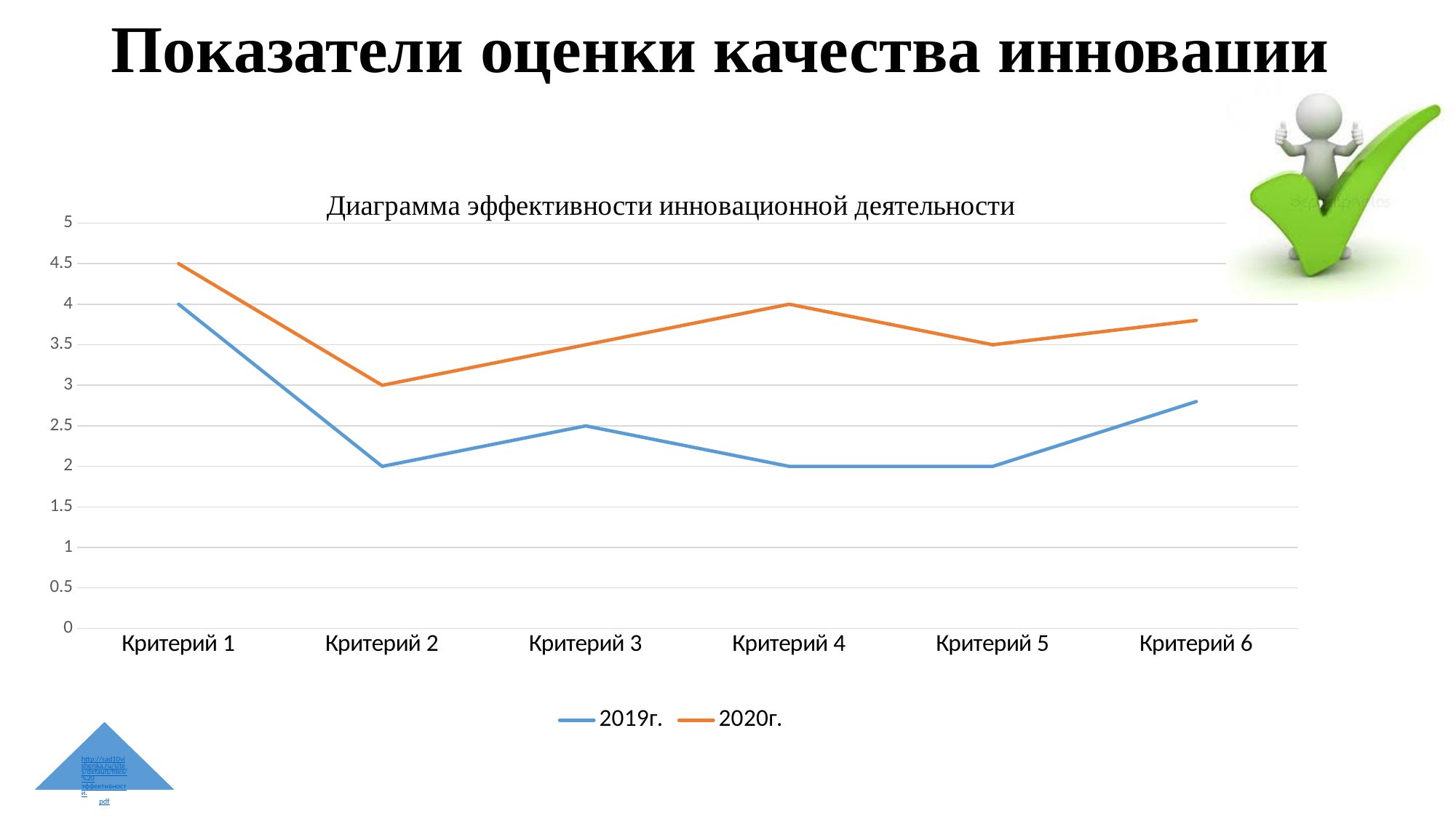
Do the values of the 2019г. series rise or fall from Критерий 1 to Критерий 2? fall What is the difference between the 2020г. and 2019г. values for Критерий 1? 0.5 What is the value for Критерий 1 in the 2020г. series? 4.5 What is the value for Критерий 2 in the 2019г. series? 2 Which category has the lowest value in the 2020г. series? Критерий 2 What type of chart is shown on the slide? Line chart How many series does the legend list? 2 How many categories are shown on the x axis? 6 What is the value for Критерий 4 in the 2020г. series? 4 Is the value for Критерий 6 in the 2019г. series greater or less than 2.5? greater What is the title of the chart? Диаграмма эффективности инновационной деятельности Which category has the highest value in the 2020г. series? Критерий 1